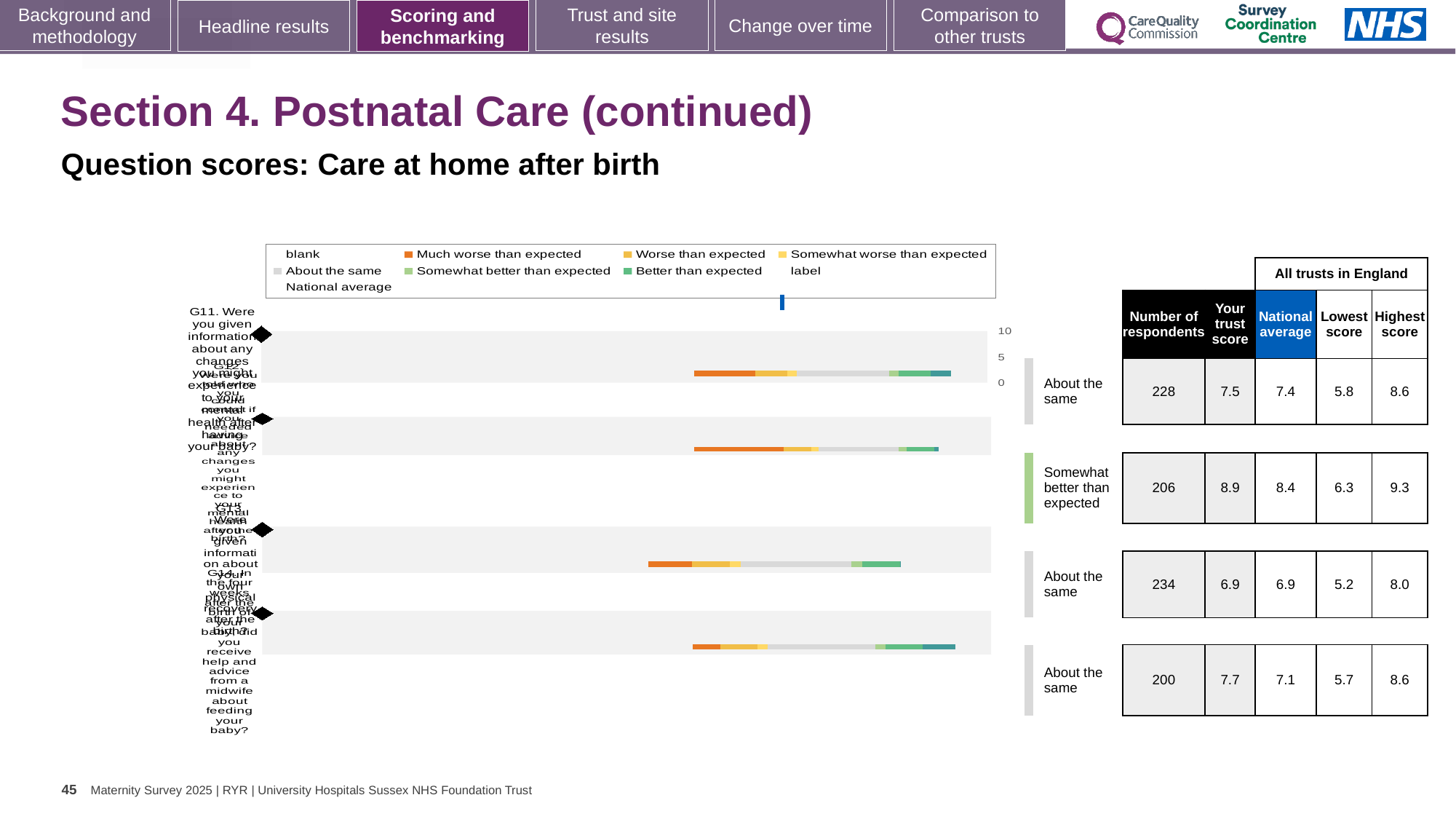
For the fourth (bottom) question row, which is larger: the trust score or the national average? the trust score (7.7) In the table beside the chart, what is the national average for the third question row? 6.9 In the table beside the chart, what is the number of respondents for the first (top) question row? 228 In the table beside the chart, what is the trust score for the row rated 'Somewhat better than expected'? 8.9 What kind of chart is shown on the slide? bar chart How many question rows (bars) does the chart show? 4 In the table beside the chart, what is the lowest score for the second question row? 6.3 Which question row has the fewest respondents in the table beside the chart? the fourth (bottom) row, 200 For the row rated 'Somewhat better than expected', what is the difference between the trust score and the national average? 0.5 Which question row has the highest trust score in the table beside the chart? the second row (Somewhat better than expected), 8.9 In the table beside the chart, what is the highest score for the fourth (bottom) question row? 8.6 In the chart legend, which colour represents 'Much worse than expected'? orange